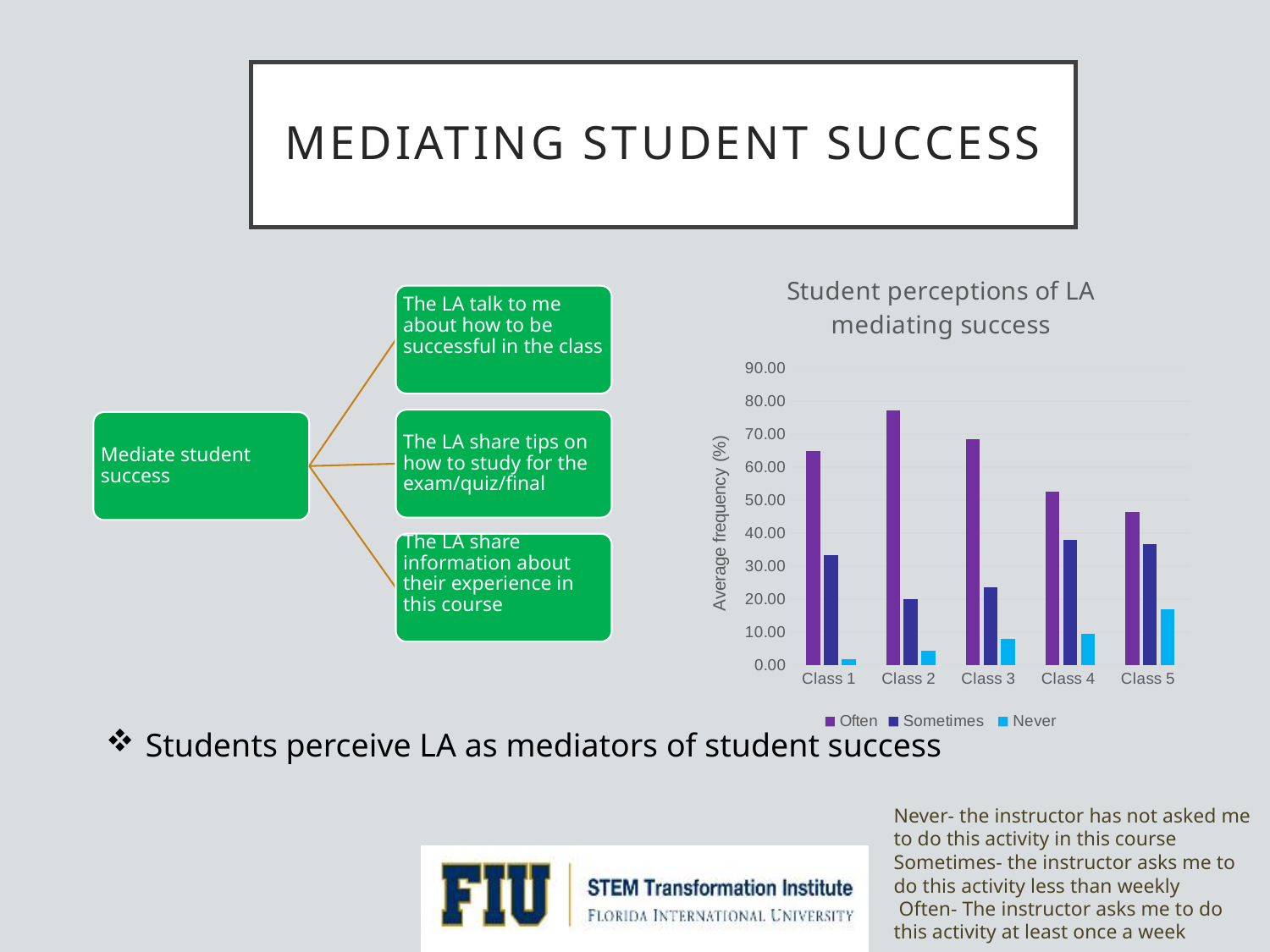
Which class has the highest value for Never? Class 5 Is the Often value for Class 5 greater or less than 50.00? less How many series does the chart legend list? 3 How many classes are shown on the x axis of the chart? 5 Which is larger, the Often value for Class 1 or the Often value for Class 4? Class 1 Which class has the highest value for Often? Class 2 What type of chart is shown on the slide? bar chart Which class has the lowest value for Never? Class 1 What is the title of the chart? Student perceptions of LA mediating success Is the Never value for Class 5 greater or less than 10.00? greater Is the Often value for Class 2 greater or less than 70.00? greater Which class has the lowest value for Often? Class 5